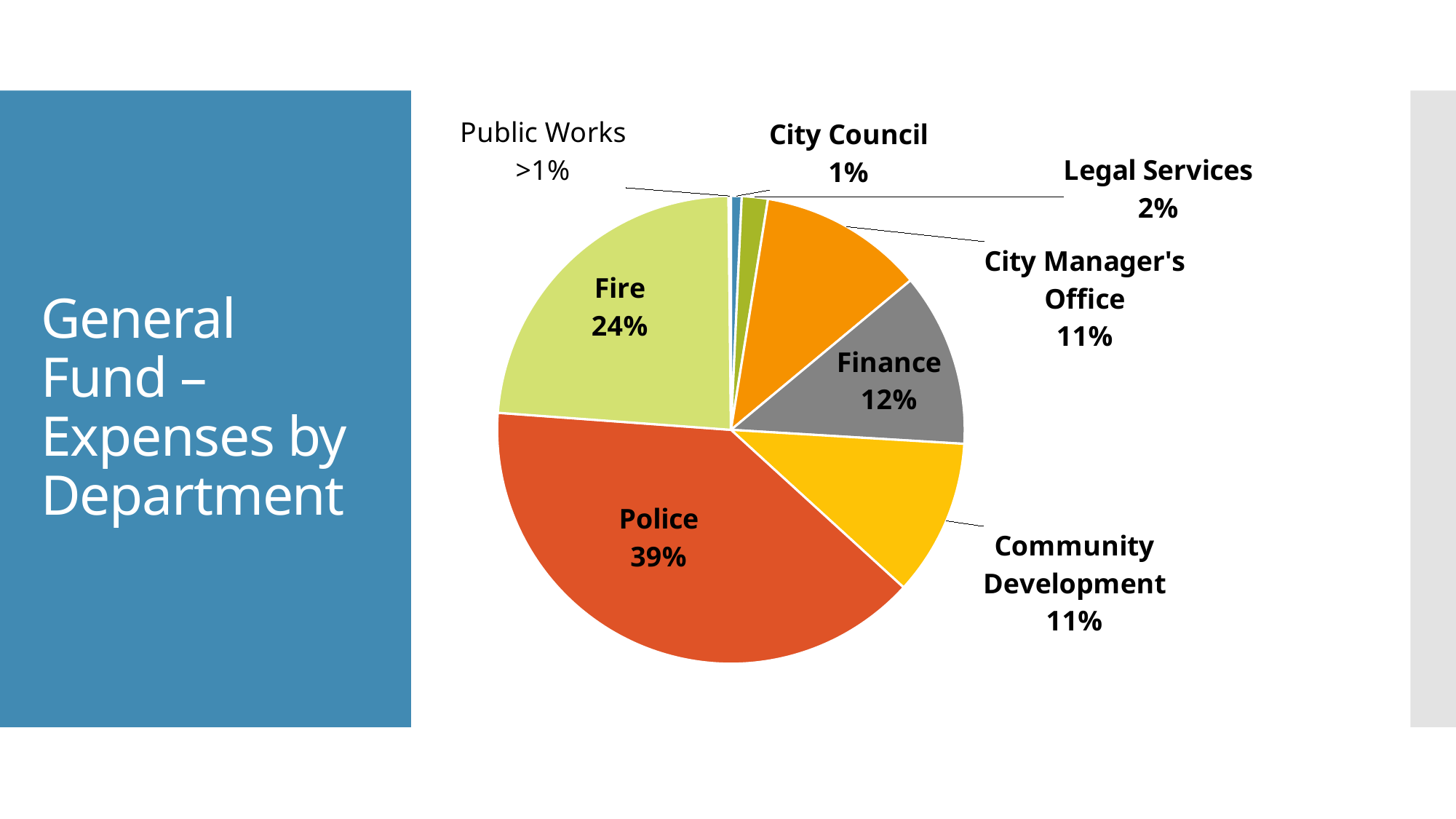
How many percentage points larger is the Police share than the Fire share? 15 What percentage is shown for Legal Services? 2% Which department has the largest share of expenses? Police What kind of chart is shown on the slide? pie chart How many departments are shown in the pie chart? 8 What percentage of expenses is attributed to Fire? 24% What share of General Fund expenses goes to Police? 39% What is the combined share of Police and Fire? 63% What is the title of the slide containing the chart? General Fund – Expenses by Department What is the value shown for Finance? 12% What percentage is shown for City Council? 1% Which is larger, the share for Fire or the share for Finance? Fire